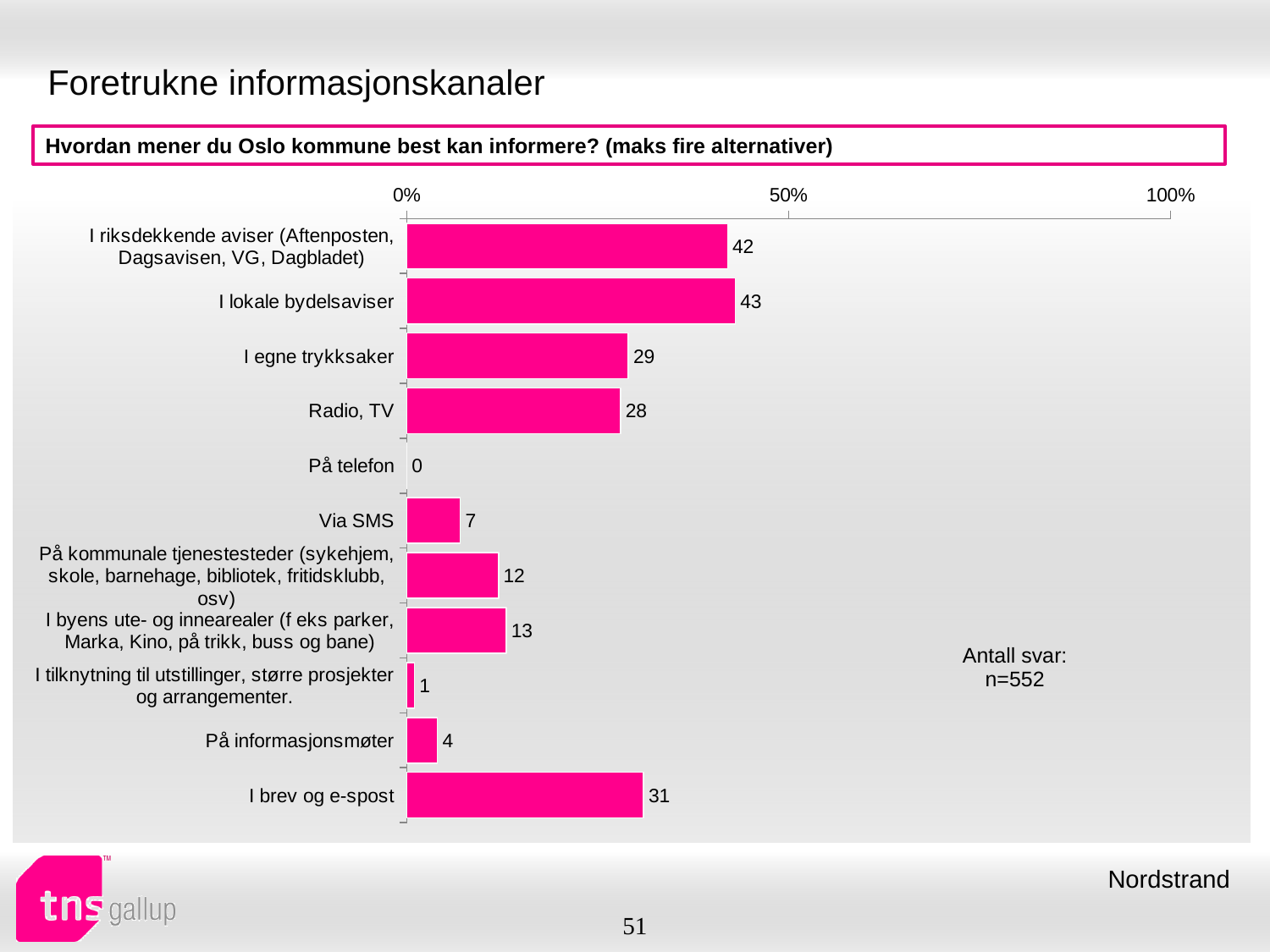
Which category has the lowest value? På telefon What is the value for "Radio, TV"? 28 Which category has the highest value? I lokale bydelsaviser Which is larger: the value for "I brev og e-spost" or the value for "I egne trykksaker"? I brev og e-spost What is the value for "I lokale bydelsaviser"? 43 What is the value for "Via SMS"? 7 Is the value for "I riksdekkende aviser (Aftenposten, Dagsavisen, VG, Dagbladet)" greater or less than 50%? less What is the difference between the values for "I egne trykksaker" and "Via SMS"? 22 What is the number of responses (n) stated on the slide? n=552 What is the value for "I brev og e-spost"? 31 What kind of chart is shown on the slide? bar chart How many categories are shown in the chart? 11